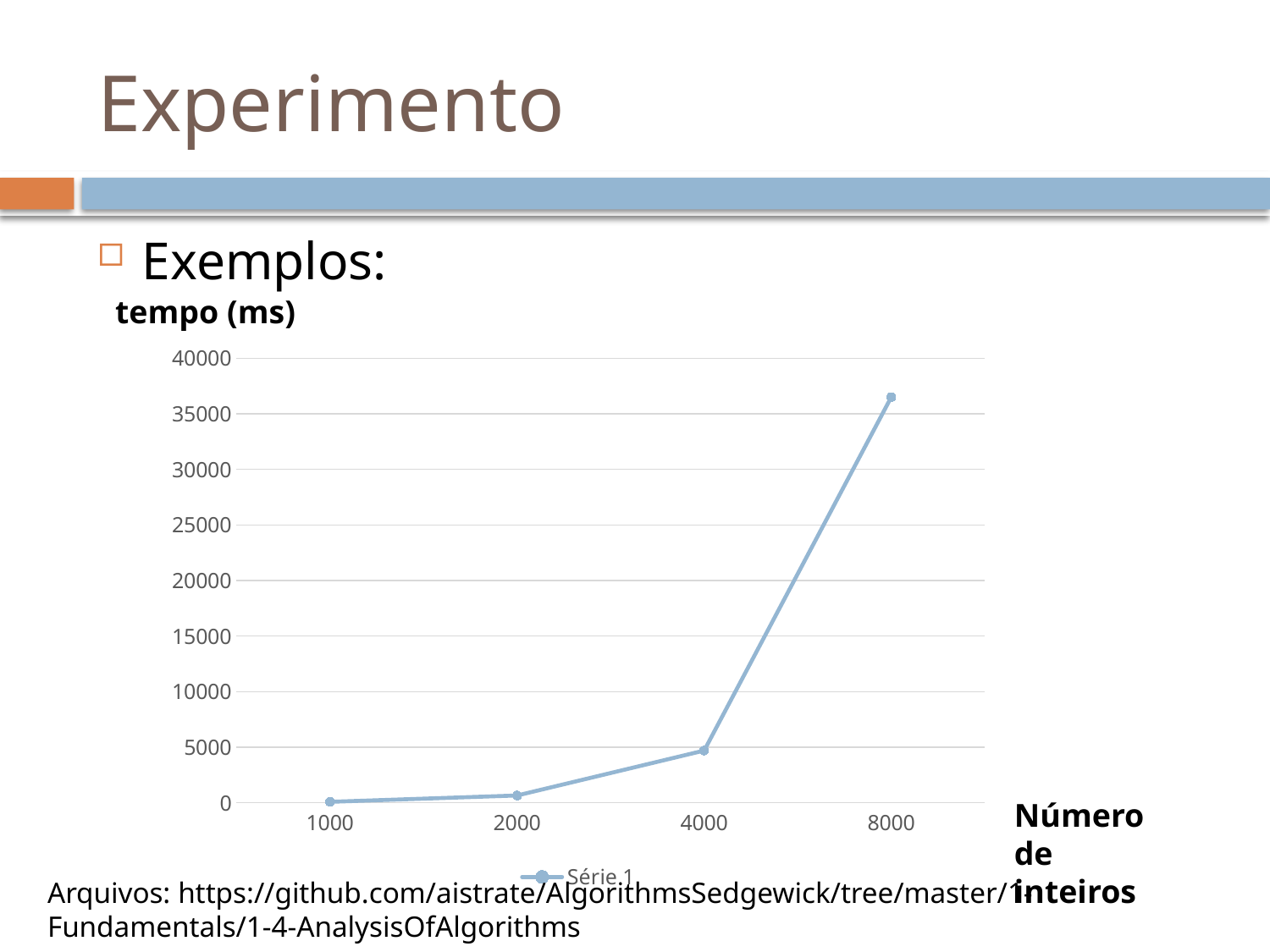
What kind of chart is shown on the slide? line chart Is the value for 4000 greater or less than 10000? less Do the values rise or fall as the number of integers increases along the x axis? rise Is the value for 8000 greater or less than 35000? greater What label is shown on the vertical axis of the chart? tempo (ms) How many series does the legend list? 1 What is the name of the series shown in the legend? Série 1 How many data points are plotted on the line? 4 Is the value for 2000 greater or less than 5000? less Which number of integers has the highest time value? 8000 Which has a larger value, 2000 or 4000? 4000 Which has a larger value, 4000 or 8000? 8000